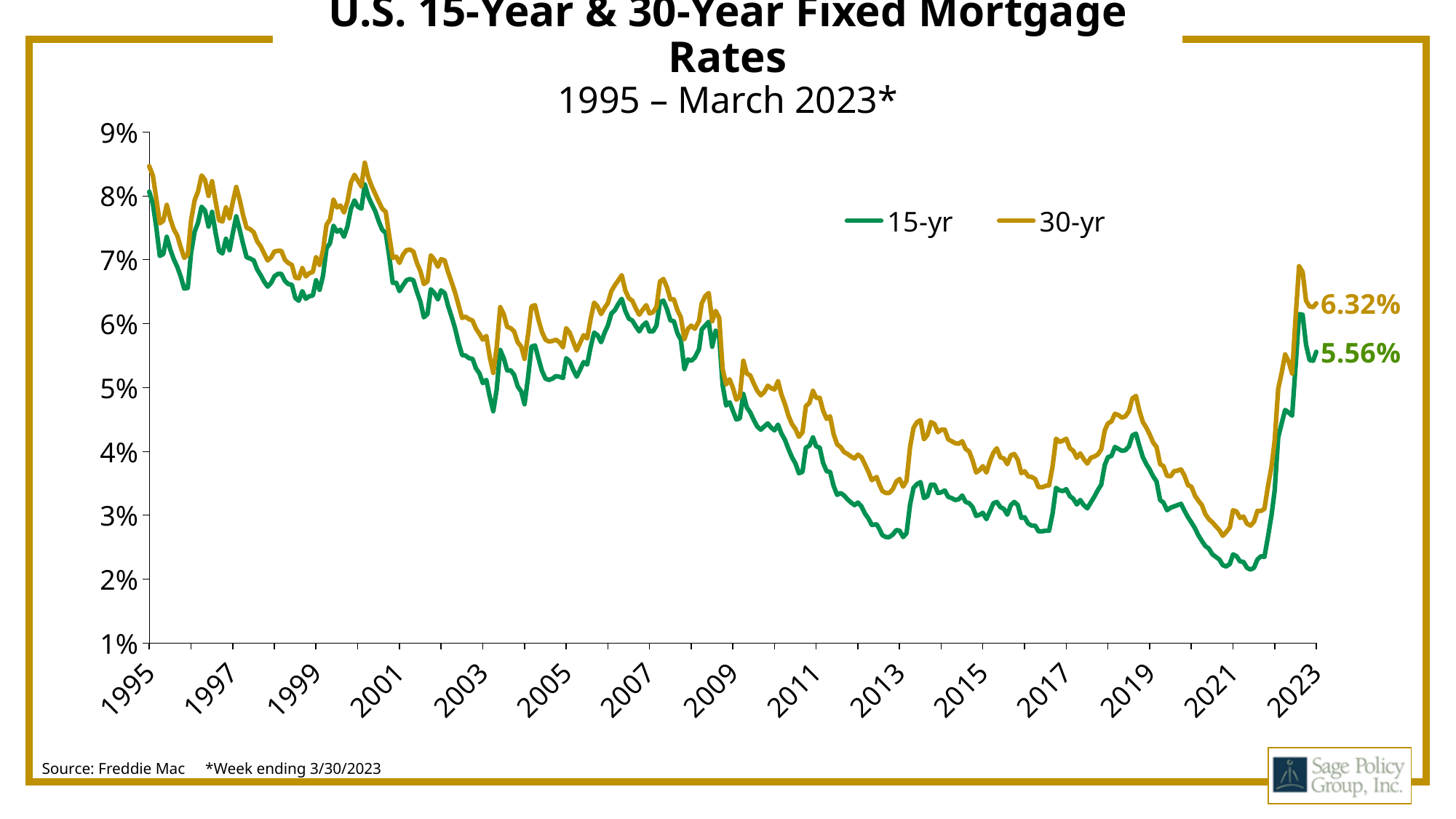
Is the 30-yr rate at the start of 2013 greater or less than 4%? less What is the latest value shown for the 30-yr series? 6.32% Overall, do mortgage rates rise or fall from 1995 to 2021? Fall What is the latest value shown for the 15-yr series? 5.56% What is the difference between the latest 30-yr rate and the latest 15-yr rate? 0.76 percentage points Is the 15-yr rate at the start of 2021 greater or less than 3%? less What kind of chart is shown on the slide? Line chart Do the rates rise or fall between 2021 and 2023? Rise How many series does the legend list? 2 What is the source cited for the chart data? Freddie Mac Is the 30-yr rate at the start of 1995 greater or less than 8%? greater At the end of the series in March 2023, which rate is higher, the 15-yr or the 30-yr? 30-yr